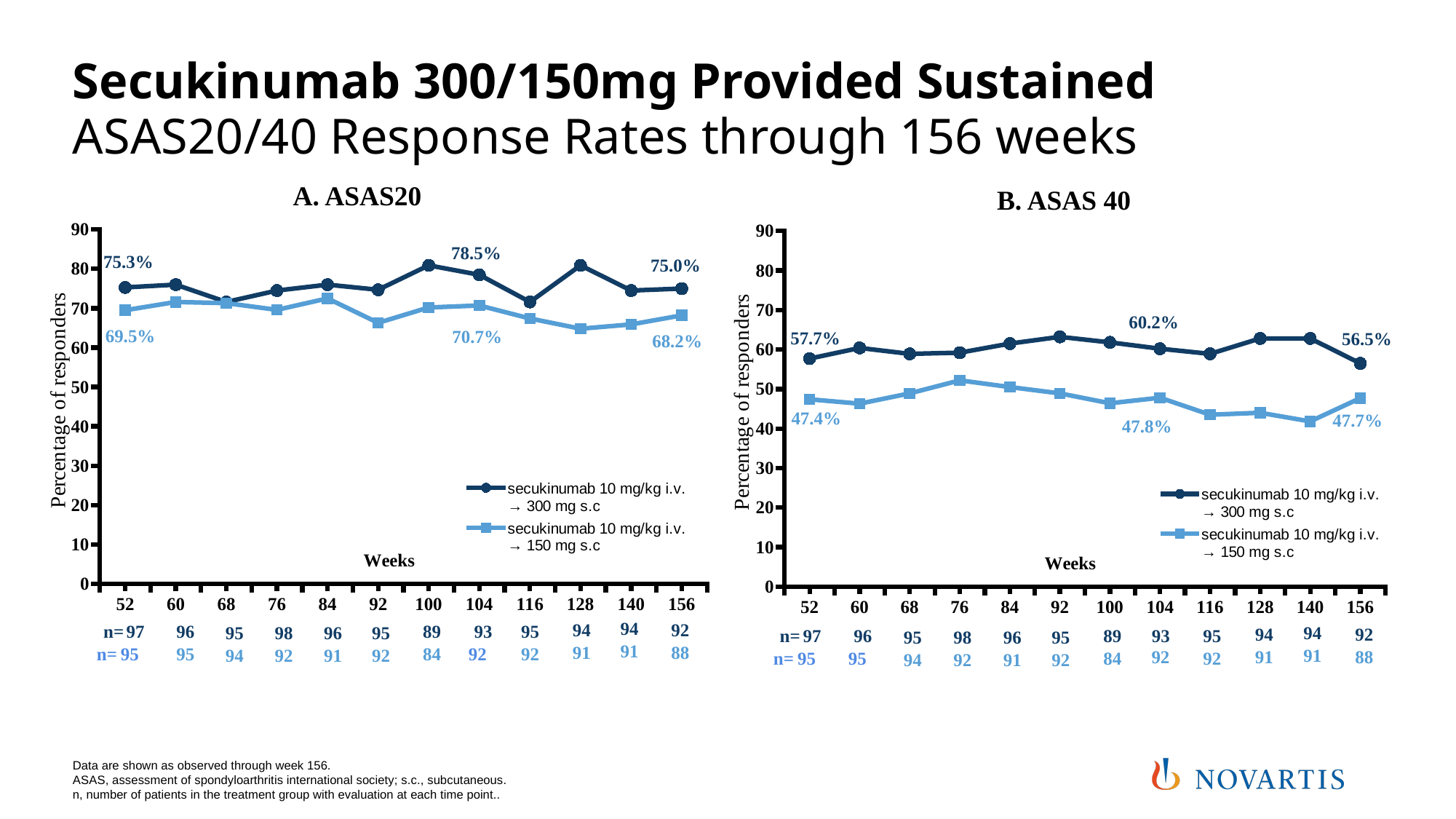
What kind of chart is chart B (ASAS 40)? Line chart In chart A (ASAS20), is the value for the 150 mg s.c. group at week 92 greater or less than 70? less In chart B (ASAS 40), what is the difference between the 300 mg s.c. and 150 mg s.c. response rates at week 156? 8.8 percentage points In chart A (ASAS20), what is the response rate at week 156 for the 150 mg s.c. group? 68.2% In chart A (ASAS20), what is the difference between the 300 mg s.c. and 150 mg s.c. response rates at week 52? 5.8 percentage points In chart B (ASAS 40), is the value for the 150 mg s.c. group at week 76 greater or less than 50? greater How many week time points are shown on the x axis of chart B (ASAS 40)? 12 In chart A (ASAS20), what is the ASAS20 response rate at week 52 for the secukinumab 10 mg/kg i.v. → 300 mg s.c. group? 75.3% How many series does the legend of chart A (ASAS20) list? 2 In chart A (ASAS20), which group has the higher response rate at week 156, the 300 mg s.c. group or the 150 mg s.c. group? 300 mg s.c. group In chart B (ASAS 40), what is the response rate at week 52 for the 150 mg s.c. group? 47.4% In chart B (ASAS 40), what is the response rate at week 156 for the 300 mg s.c. group? 56.5%